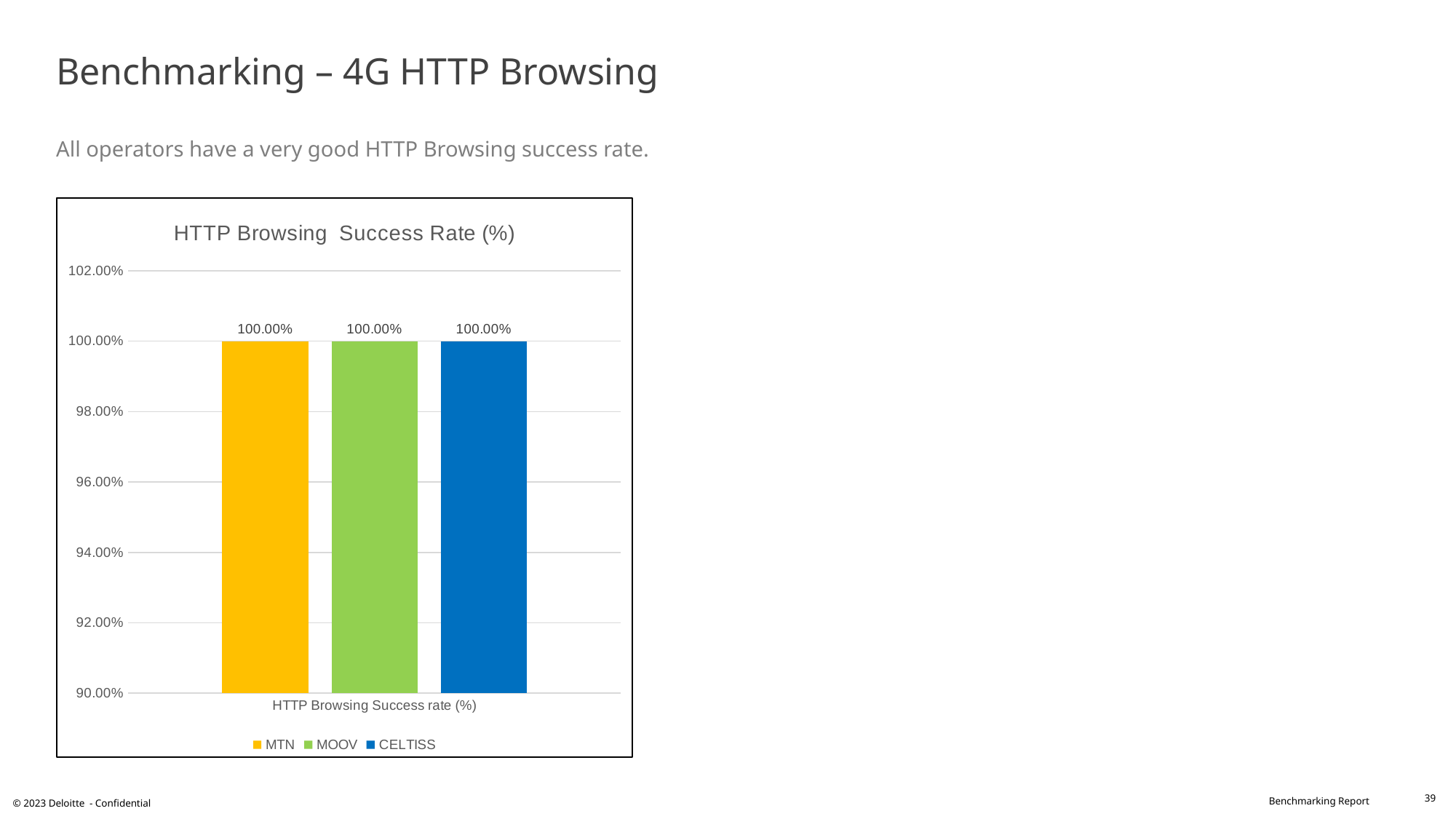
Do all three operators have the same HTTP Browsing success rate? Yes What is the HTTP Browsing success rate for MTN? 100.00% How many series does the legend list? 3 What is the HTTP Browsing success rate for CELTISS? 100.00% What is the difference between the success rates of MTN and CELTISS? 0.00% How many bars are plotted in the chart? 3 What is the title of the chart? HTTP Browsing Success Rate (%) What kind of chart is shown on the slide? bar chart What is the HTTP Browsing success rate for MOOV? 100.00% Which colour represents CELTISS in the chart? blue Is the value for MOOV greater or less than 98.00%? greater